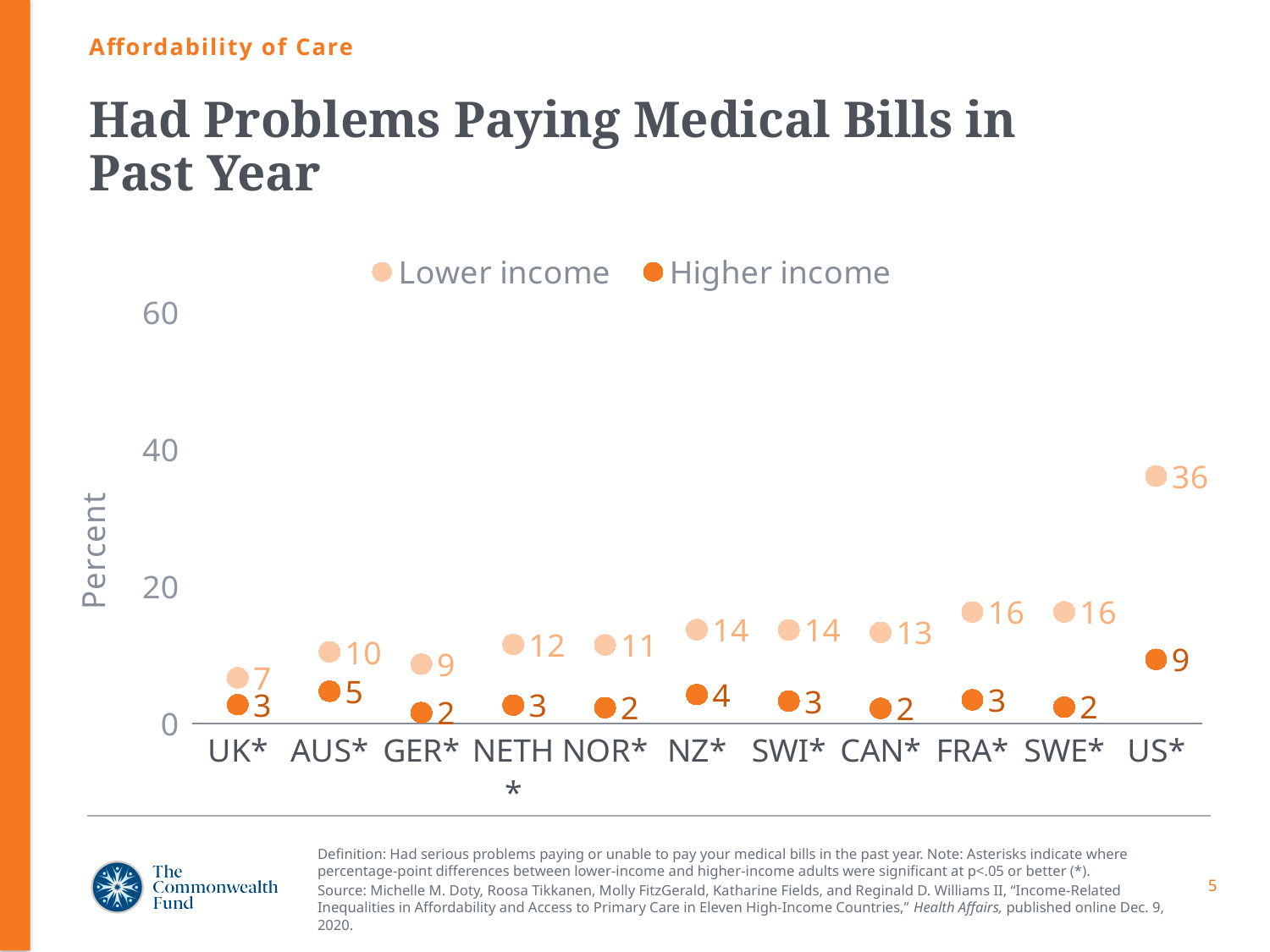
What is the Lower income value for GER*? 9 What is the Higher income value for NZ*? 4 Which country has the lowest Lower income value? UK* What is the label on the y axis? Percent What is the title of the chart? Had Problems Paying Medical Bills in Past Year How many countries are shown on the x axis? 11 What is the difference between the Lower income and Higher income values for US*? 27 What is the Lower income value for US*? 36 How many series does the legend list? 2 Which country has the highest Lower income value? US* What kind of chart is this? Scatter (dot) chart Which is larger, the Lower income value for AUS* or the Lower income value for NETH*? NETH*